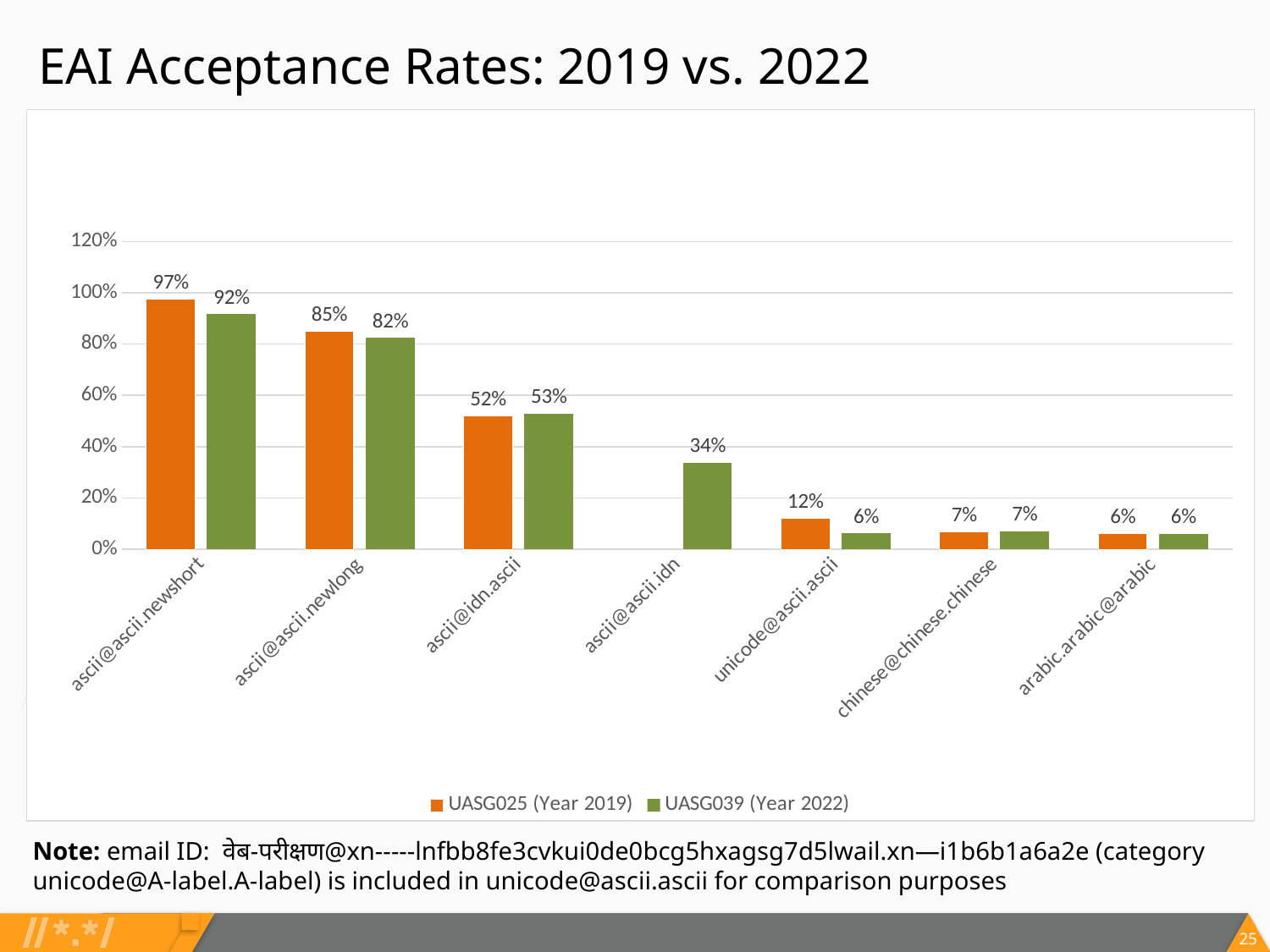
What kind of chart is shown on the slide? bar chart For ascii@idn.ascii, which is larger: the UASG025 (Year 2019) value or the UASG039 (Year 2022) value? UASG039 (Year 2022) What is the UASG039 (Year 2022) value for unicode@ascii.ascii? 6% Which category has the lowest UASG025 (Year 2019) acceptance rate? arabic.arabic@arabic How many series does the legend list? 2 What is the UASG039 (Year 2022) acceptance rate for ascii@ascii.idn? 34% Is the UASG039 (Year 2022) value for ascii@ascii.newlong greater or less than 60%? greater What is the difference between the 2019 and 2022 acceptance rates for ascii@ascii.newshort? 5% How many categories are shown on the x axis? 7 What is the UASG025 (Year 2019) acceptance rate for ascii@ascii.newshort? 97% What is the difference between the 2019 and 2022 values for unicode@ascii.ascii? 6% Which category has the highest UASG039 (Year 2022) acceptance rate? ascii@ascii.newshort